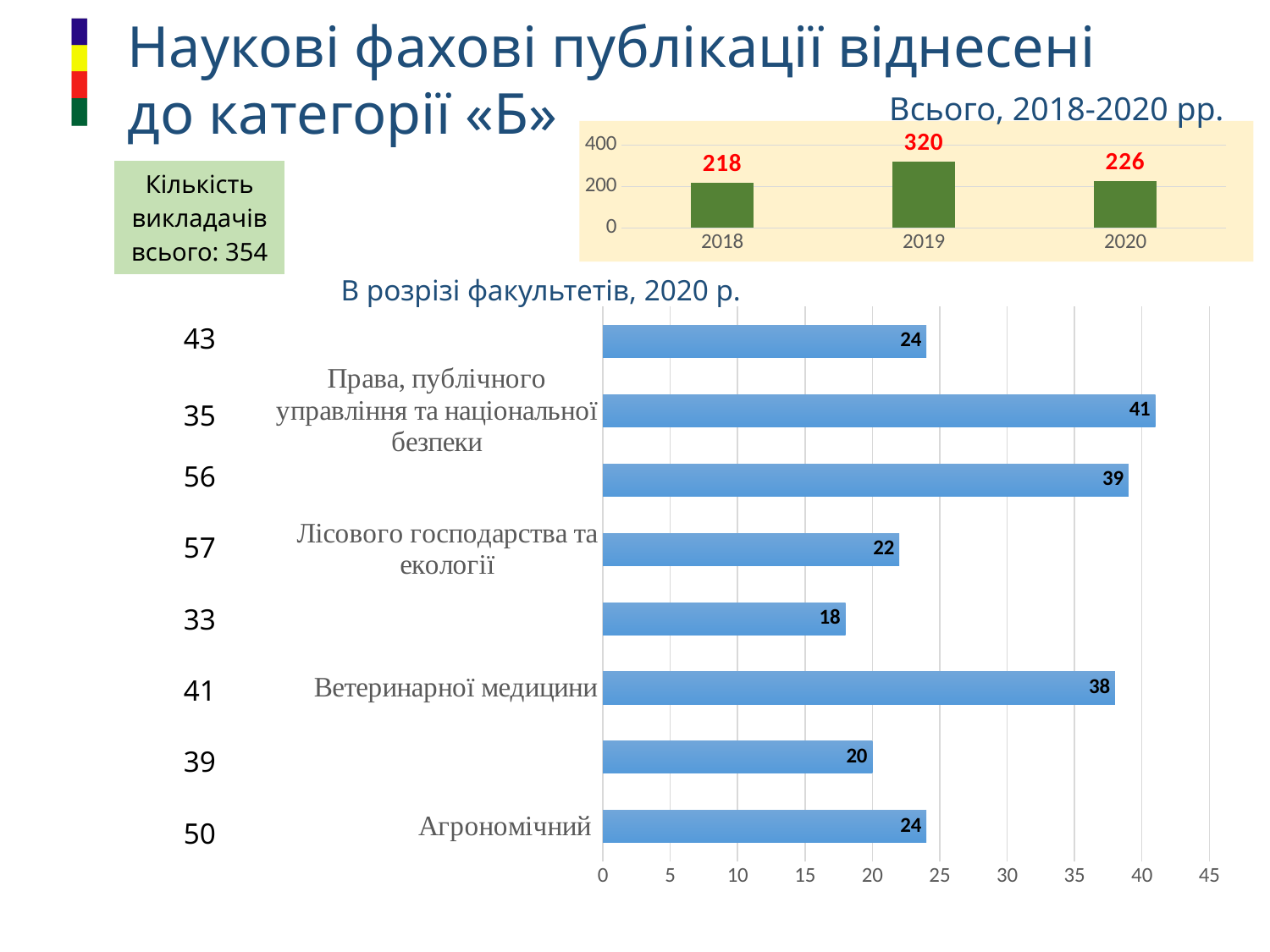
In the chart titled 'Всього, 2018-2020 рр.', which year has the highest value? 2019 In the chart titled 'В розрізі факультетів, 2020 р.', what is the value for 'Ветеринарної медицини'? 38 In the chart titled 'Всього, 2018-2020 рр.', how many years are shown? 3 In the chart titled 'В розрізі факультетів, 2020 р.', what is the value for 'Лісового господарства та екології'? 22 In the chart titled 'В розрізі факультетів, 2020 р.', how many bars are plotted? 8 In the chart titled 'Всього, 2018-2020 рр.', what is the value for 2018? 218 In the chart titled 'В розрізі факультетів, 2020 р.', what is the value for 'Права, публічного управління та національної безпеки'? 41 In the chart titled 'Всього, 2018-2020 рр.', what is the value for 2019? 320 In the chart titled 'Всього, 2018-2020 рр.', which year has the lowest value? 2018 In the chart titled 'Всього, 2018-2020 рр.', what is the difference between the values for 2019 and 2020? 94 What kind of chart is the one titled 'В розрізі факультетів, 2020 р.'? bar chart In the chart titled 'В розрізі факультетів, 2020 р.', which is larger: the value for 'Агрономічний' or for 'Лісового господарства та екології'? Агрономічний